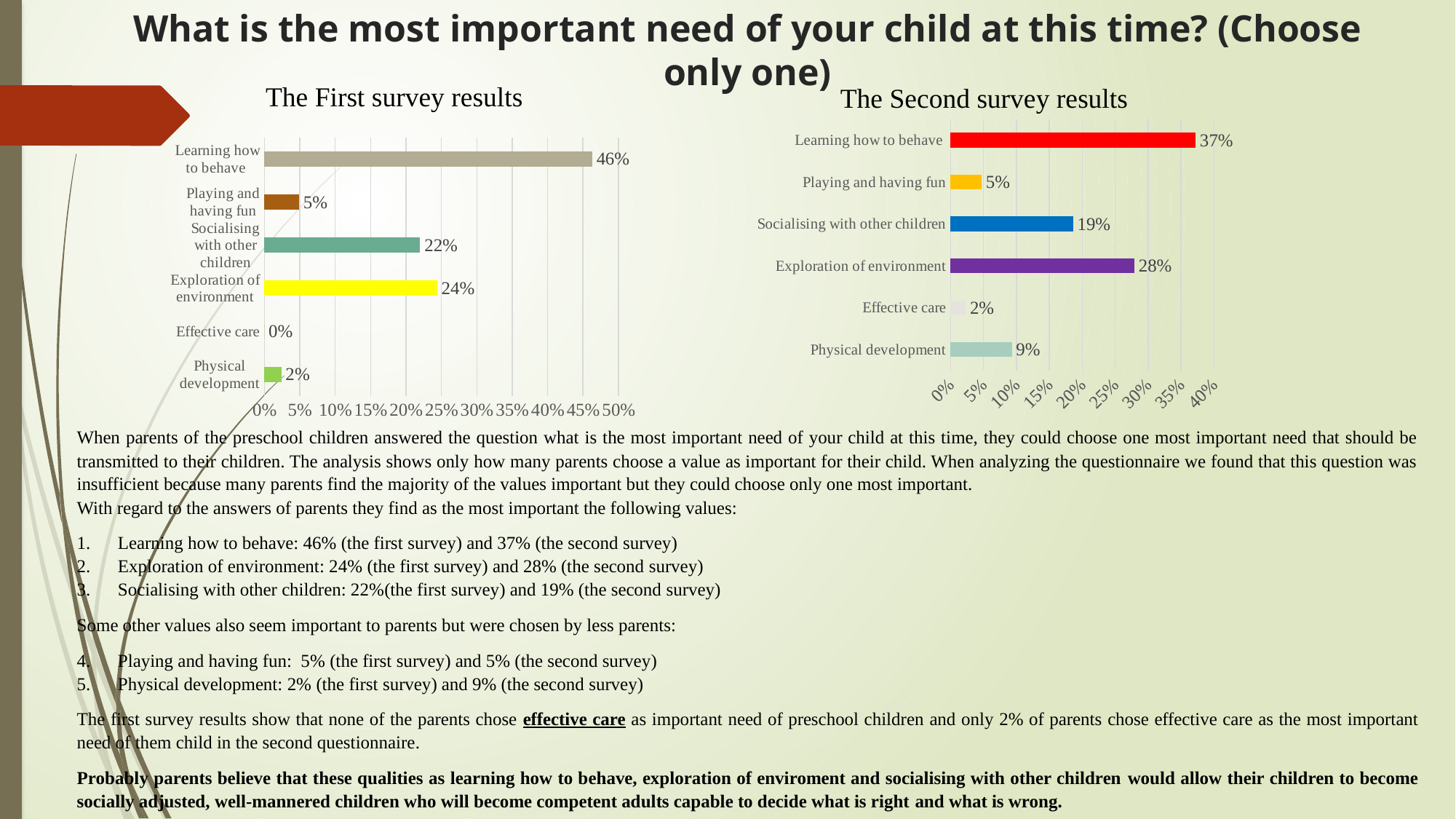
What kind of chart is "The First survey results"? Bar chart In the chart titled "The First survey results", what is the difference between Exploration of environment and Socialising with other children? 2% In the chart titled "The First survey results", is the value for Learning how to behave greater or less than 40%? greater In the chart titled "The Second survey results", which category has the lowest value? Effective care In the chart titled "The Second survey results", what is the difference between Learning how to behave and Physical development? 28% In the chart titled "The Second survey results", which is larger: Socialising with other children or Physical development? Socialising with other children In the chart titled "The First survey results", what is the value for Learning how to behave? 46% In the chart titled "The First survey results", what is the value for Effective care? 0% How many categories are shown in the chart titled "The Second survey results"? 6 In the chart titled "The Second survey results", what is the value for Exploration of environment? 28% In the chart titled "The First survey results", which category has the highest value? Learning how to behave In the chart titled "The Second survey results", what colour is the bar for Learning how to behave? Red